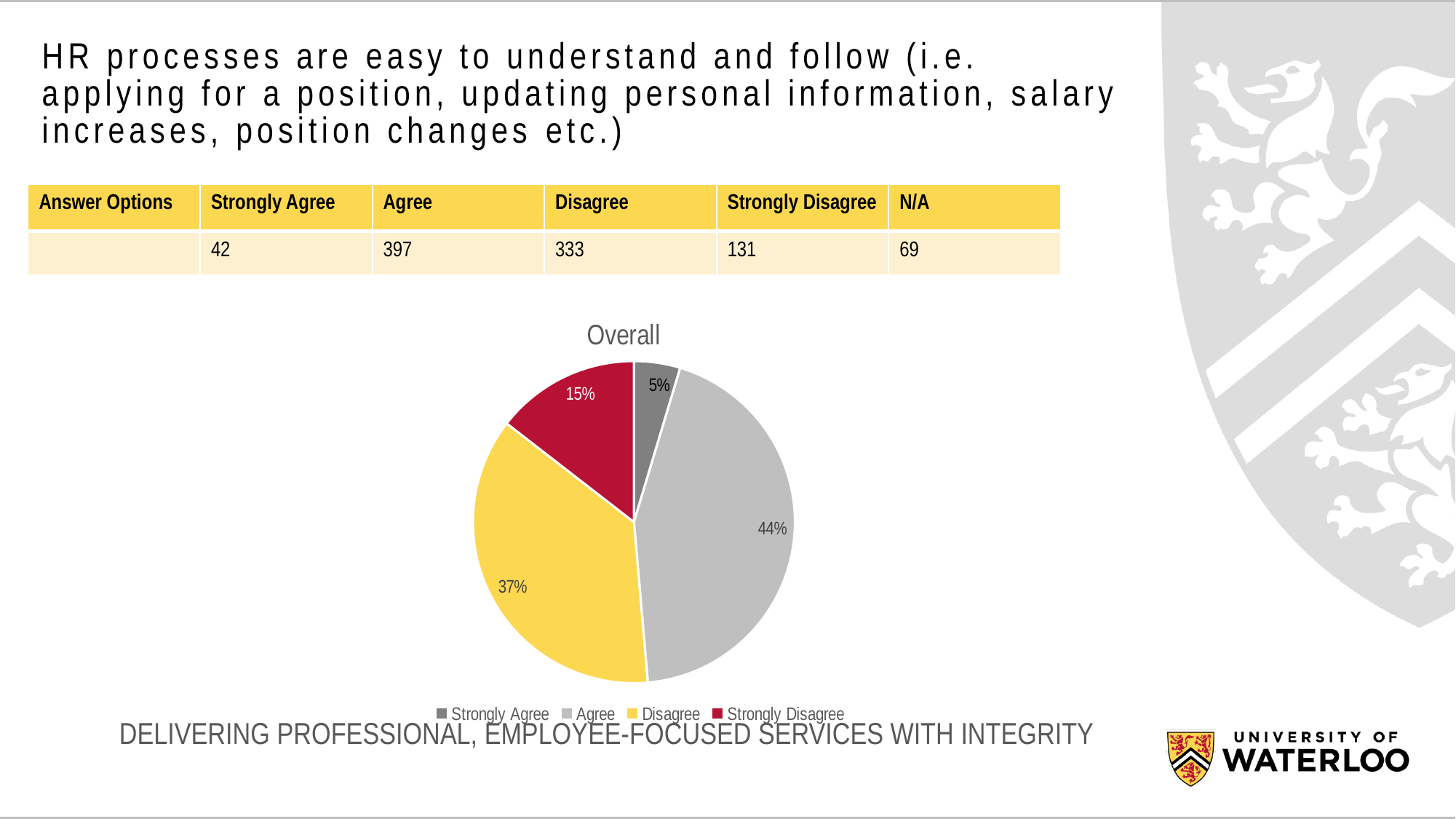
What is the title of the chart? Overall How many categories does the legend list? 4 What is the difference in percentage points between the Agree and Disagree slices? 7 What percentage of the pie does the Strongly Disagree slice represent? 15% What type of chart is shown on the slide? pie chart Which slice is larger, Strongly Disagree or Strongly Agree? Strongly Disagree Which category has the smallest slice of the pie? Strongly Agree What percentage of the pie does the Disagree slice represent? 37% What percentage of the pie does the Strongly Agree slice represent? 5% What colour is the Disagree slice? yellow Which category has the largest slice of the pie? Agree